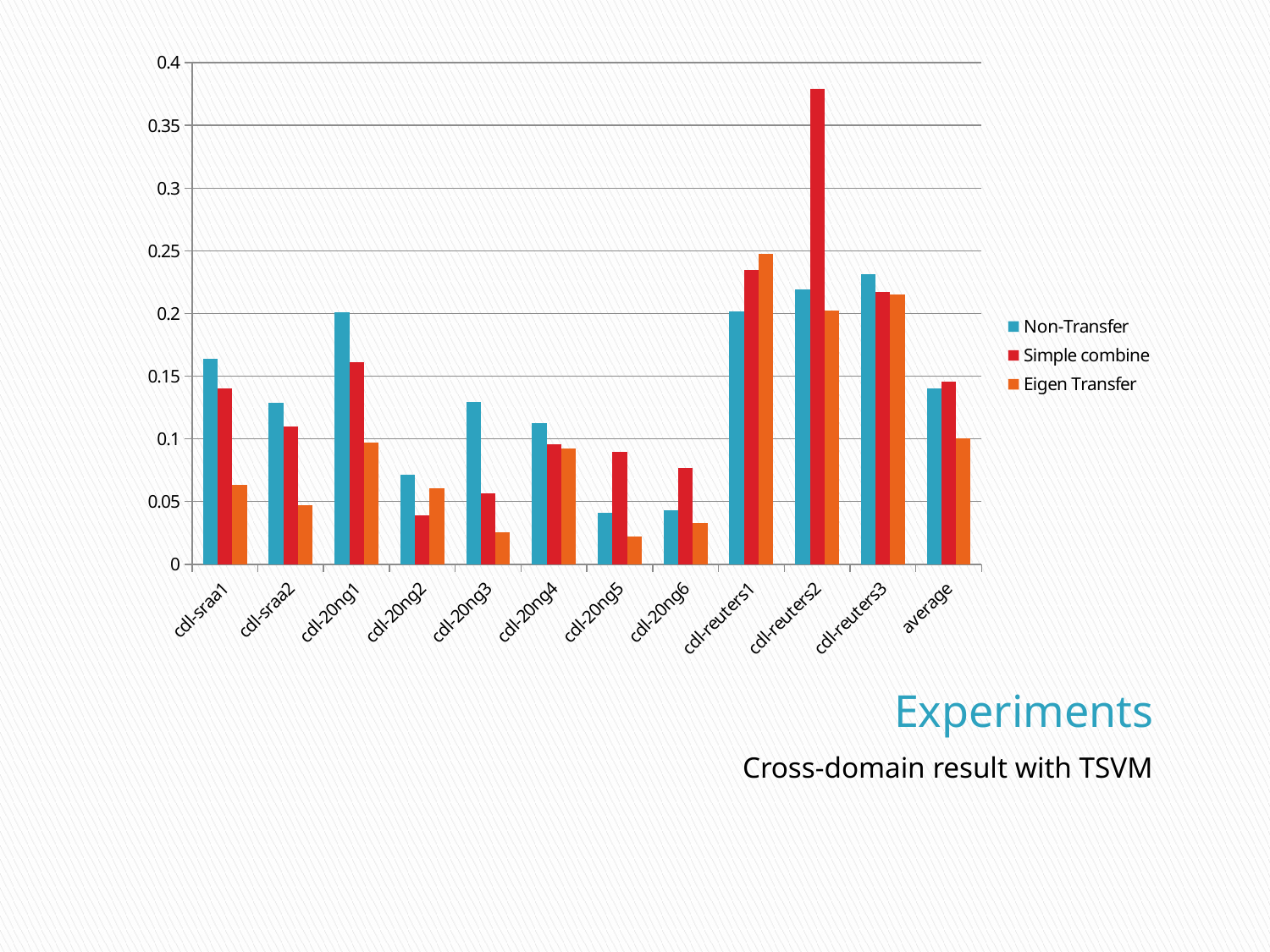
How many series does the legend list? 3 Is the Non-Transfer value for cdl-sraa1 greater or less than 0.15? greater How many categories are shown along the x axis? 12 For which category is the Simple combine value lowest? cdl-20ng2 For cdl-reuters1, which is larger: Non-Transfer or Eigen Transfer? Eigen Transfer Is the Simple combine value for cdl-20ng6 greater or less than 0.05? greater For cdl-20ng5, which is larger: Non-Transfer or Simple combine? Simple combine What is the subtitle text below the 'Experiments' heading on the slide? Cross-domain result with TSVM What kind of chart is shown on the slide? bar chart Is the Simple combine value for cdl-reuters2 greater or less than 0.35? greater Which series and category has the tallest bar in the chart? Simple combine at cdl-reuters2